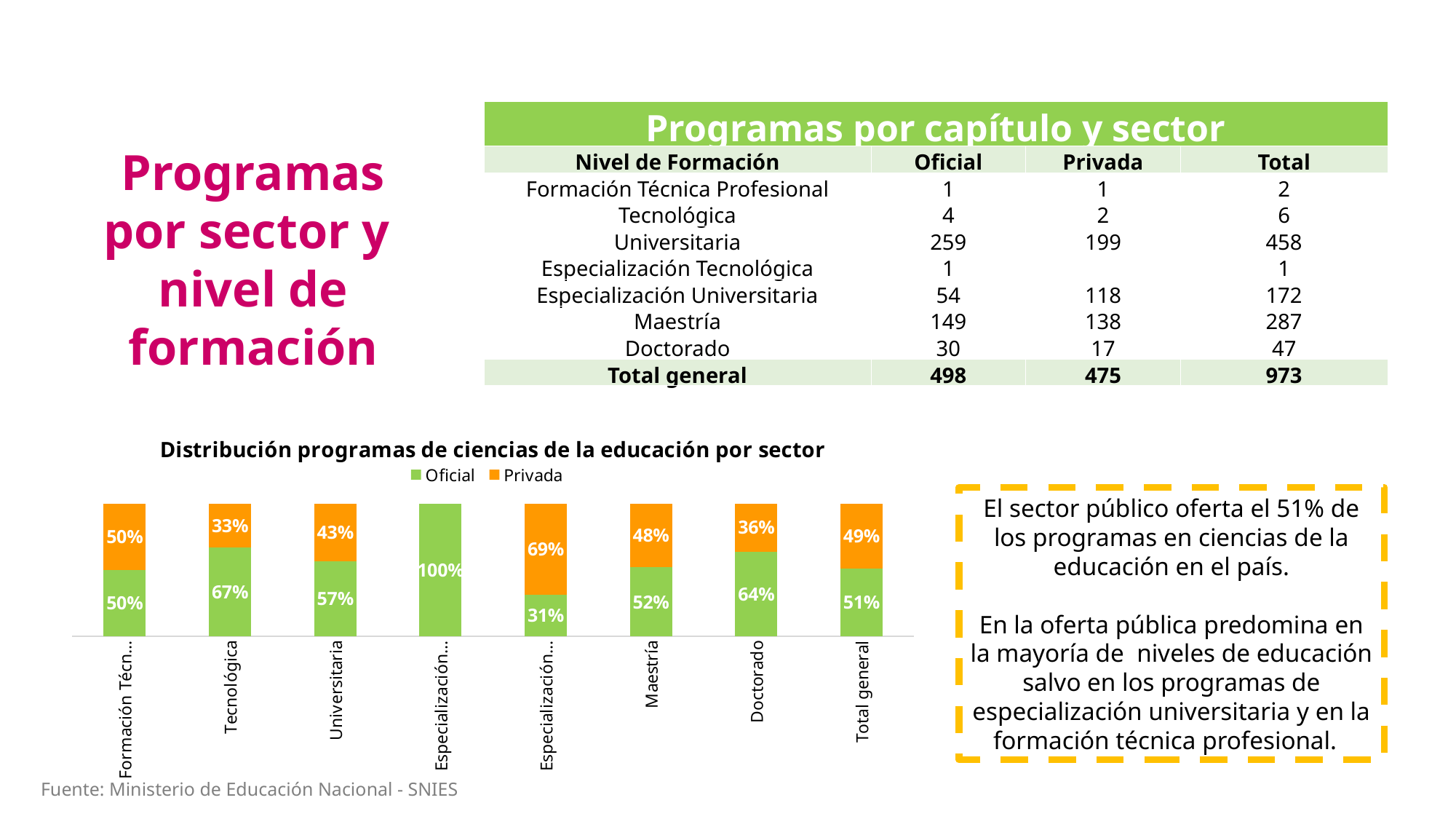
Which has a larger Oficial share in the chart, Doctorado or Universitaria? Doctorado What is the total of the stacked bar for Maestría (Oficial plus Privada)? 100% What type of chart is shown on the slide? Stacked bar chart How many series does the chart legend list? 2 How many categories are shown on the x axis of the chart? 8 What is the Privada share for Maestría in the chart? 48% By how many percentage points does the Oficial share for Doctorado exceed the Oficial share for Maestría? 12 percentage points What is the Privada share for Universitaria in the chart? 43% What is the Oficial share for Tecnológica in the chart? 67% Among Tecnológica, Universitaria, Maestría and Doctorado, which has the highest Privada share? Maestría What is the Oficial share for Total general in the chart? 51% What is the Oficial share for Doctorado in the chart? 64%